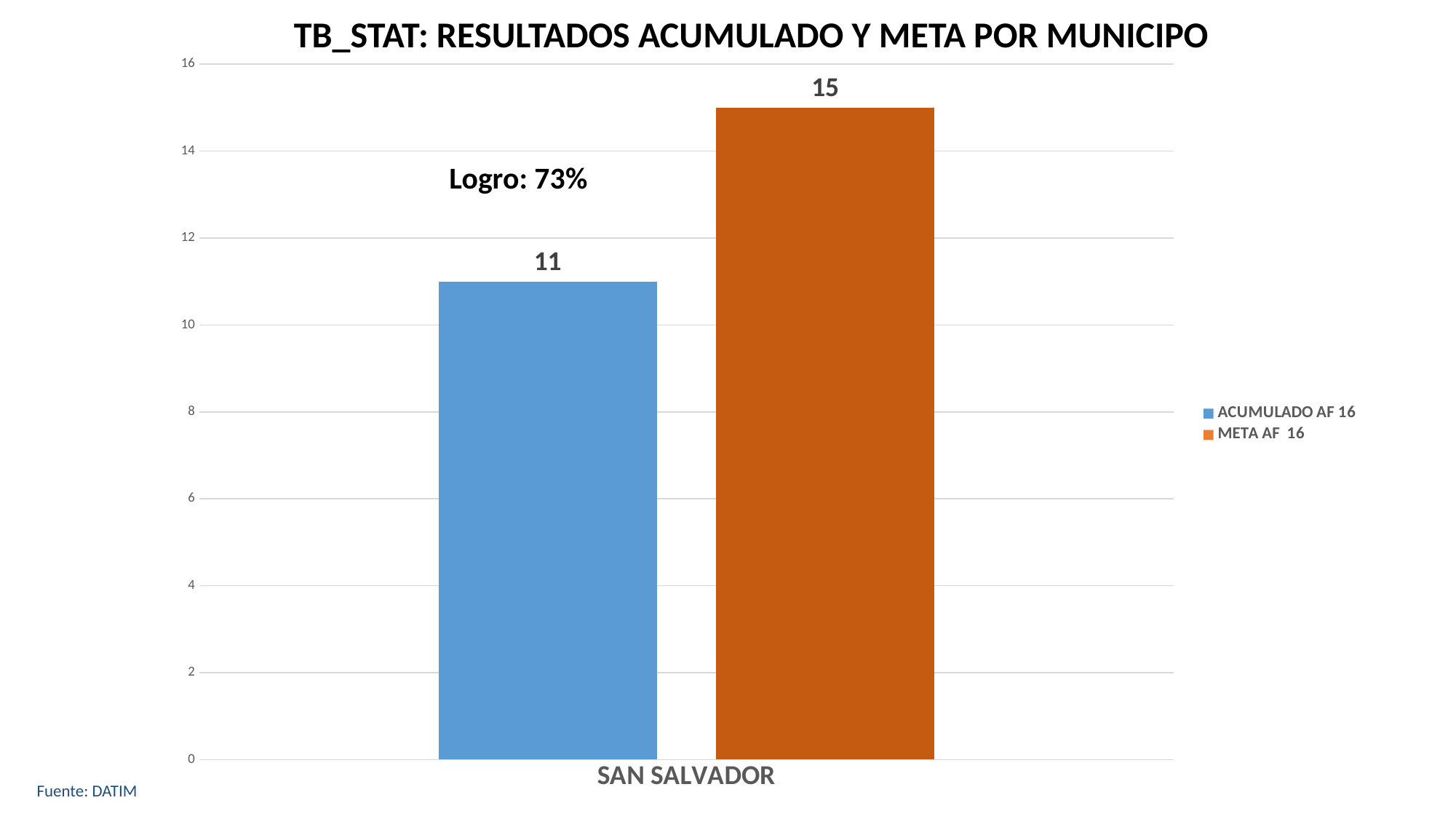
What percentage is shown as 'Logro' on the chart? 73% What is the difference between META AF 16 and ACUMULADO AF 16 for SAN SALVADOR? 4 Which series is the lowest for SAN SALVADOR? ACUMULADO AF 16 What is the title of the chart? TB_STAT: RESULTADOS ACUMULADO Y META POR MUNICIPO Is the value for META AF 16 greater or less than 16? less Which series has the higher value for SAN SALVADOR, ACUMULADO AF 16 or META AF 16? META AF 16 How many categories are shown on the x axis? 1 What kind of chart is shown on the slide? bar chart How many series does the legend list? 2 What is the value of ACUMULADO AF 16 for SAN SALVADOR? 11 What is the value of META AF 16 for SAN SALVADOR? 15 Is the value for ACUMULADO AF 16 greater or less than 10? greater